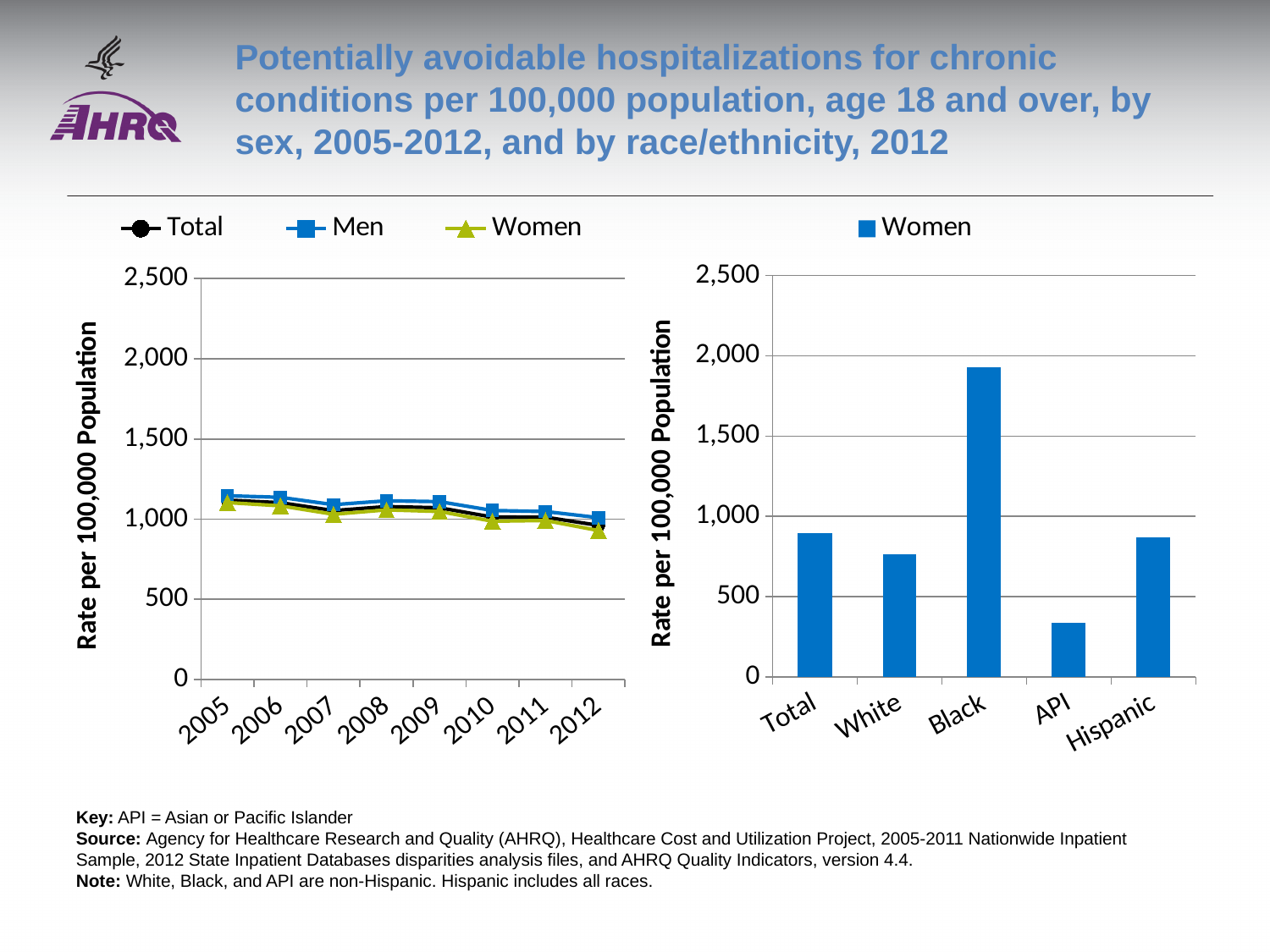
In the left chart (by sex, 2005-2012), what kind of chart is it? line chart In the right chart (by race/ethnicity, 2012), which group has the highest rate? Black In the right chart (by race/ethnicity, 2012), which is larger, the value for White or the value for Hispanic? Hispanic In the left chart (by sex, 2005-2012), is the value for Women in 2012 greater or less than 1,000? less In the left chart (by sex, 2005-2012), do the rates generally rise or fall from 2005 to 2012? fall In the left chart (by sex, 2005-2012), how many series does the legend list? 3 In the right chart (by race/ethnicity, 2012), is the value for API greater or less than 500? less In the right chart (by race/ethnicity, 2012), which group has the lowest rate? API In the left chart (by sex, 2005-2012), how many years are plotted on the x axis? 8 In the left chart (by sex, 2005-2012), is the value for Men in 2005 greater or less than 1,000? greater In the right chart (by race/ethnicity, 2012), what kind of chart is it? bar chart